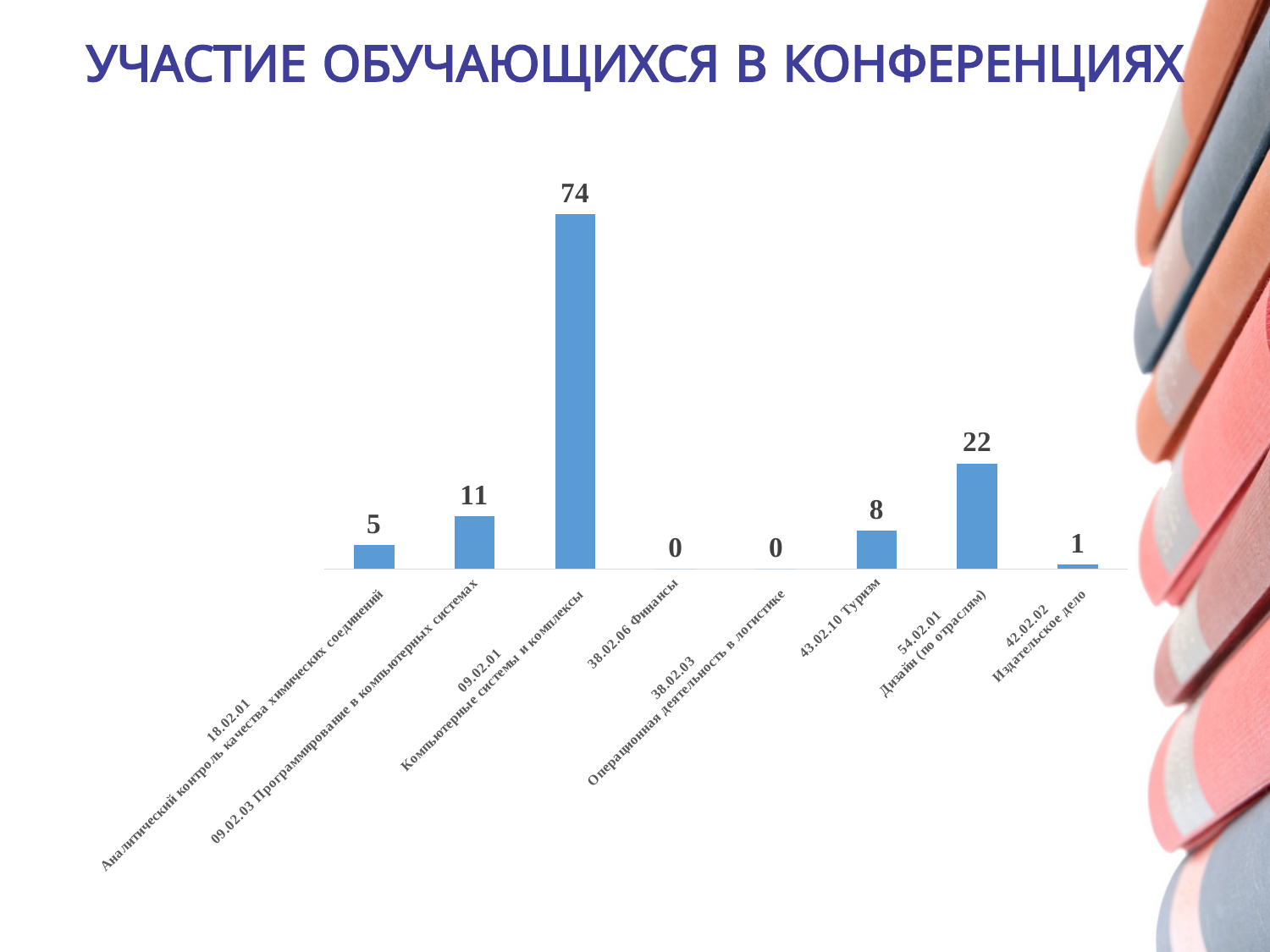
What is the difference between the values for 09.02.01 Компьютерные системы и комплексы and 54.02.01 Дизайн (по отраслям)? 52 How many categories are shown on the x axis? 8 What is the difference between the values for 09.02.03 Программирование в компьютерных системах and 18.02.01 Аналитический контроль качества химических соединений? 6 What kind of chart is shown on the slide? Bar chart What is the value for 42.02.02 Издательское дело? 1 What is the value for 38.02.06 Финансы? 0 What is the value for 09.02.01 Компьютерные системы и комплексы? 74 Which category has the highest value? 09.02.01 Компьютерные системы и комплексы What is the title of the slide? УЧАСТИЕ ОБУЧАЮЩИХСЯ В КОНФЕРЕНЦИЯХ What is the value for 54.02.01 Дизайн (по отраслям)? 22 What is the value for 43.02.10 Туризм? 8 Which is larger, the value for 43.02.10 Туризм or the value for 09.02.03 Программирование в компьютерных системах? 09.02.03 Программирование в компьютерных системах